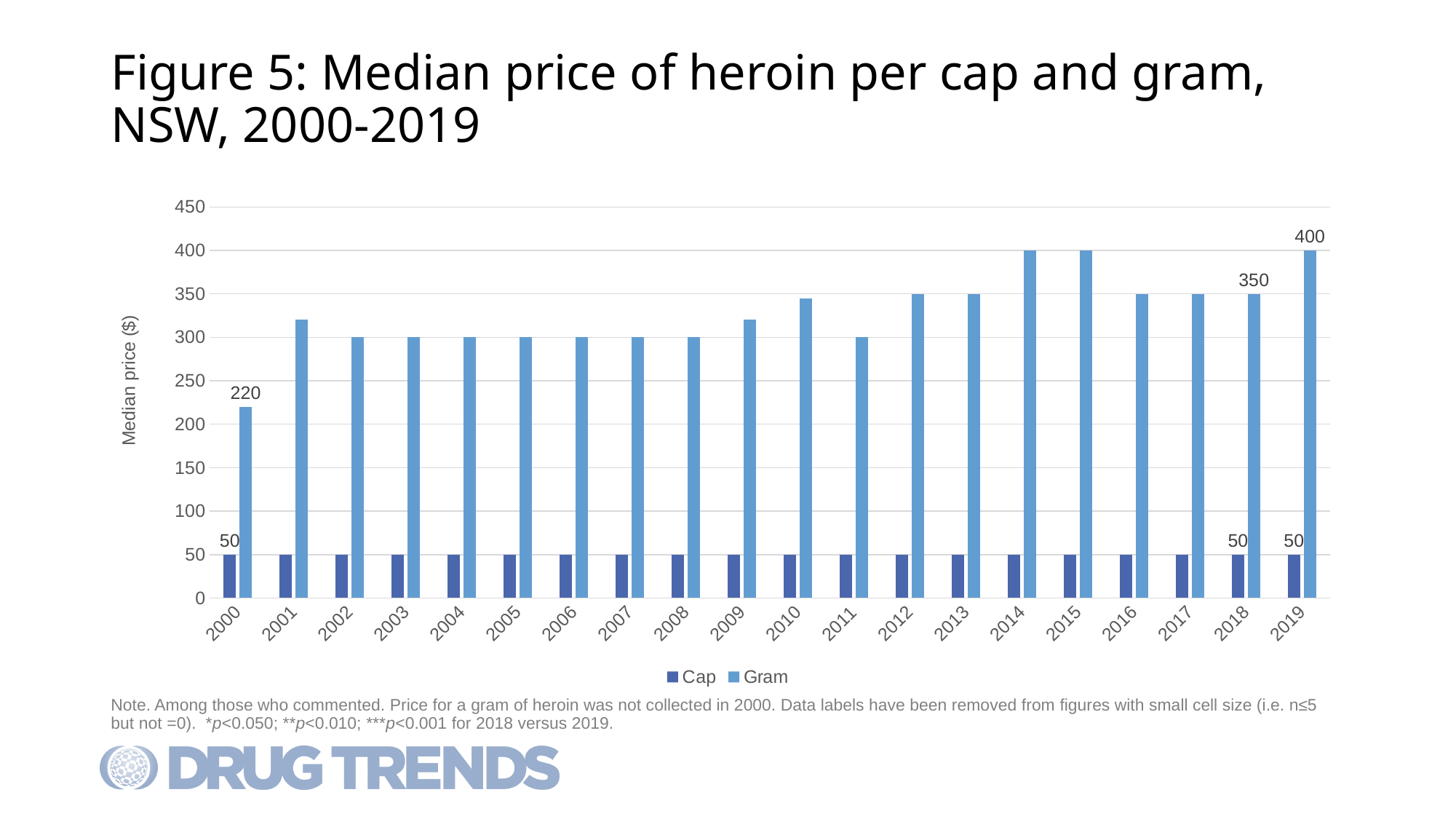
How many years are shown on the x axis? 20 By how much did the median price per gram increase from 2018 to 2019? 50 How many series does the legend list? 2 What is the median price per gram of heroin in 2018? 350 Is the median price per gram in 2010 greater or less than 300? greater What kind of chart is shown on the slide? Bar chart In which year is the median price per gram lowest? 2000 What is the median price per gram of heroin in 2000? 220 Is the median price per gram in 2001 greater or less than 350? less What is the median price per cap of heroin in 2018? 50 What is the difference between the median price per gram and per cap in 2019? 350 What is the median price per gram of heroin in 2019? 400